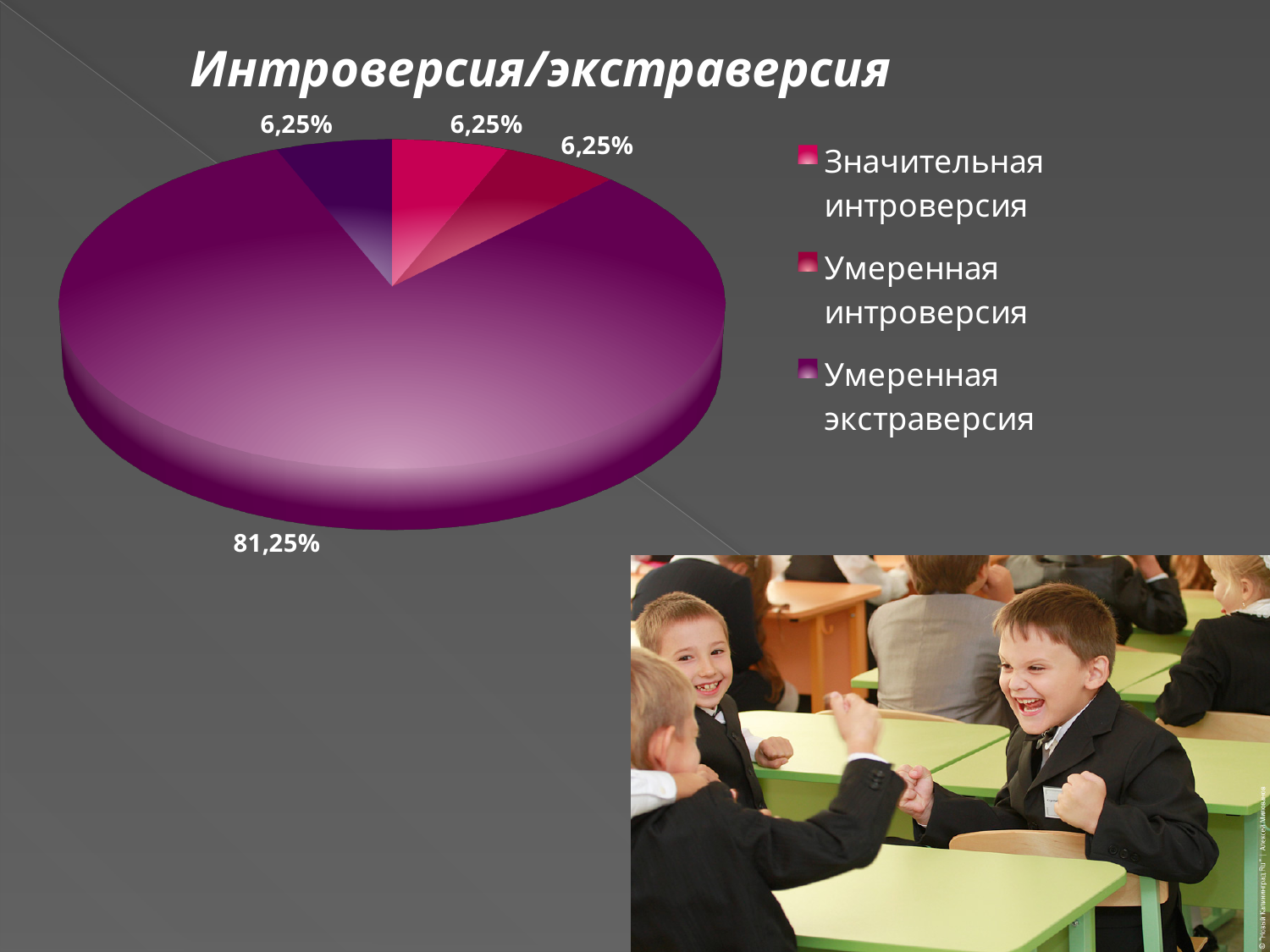
What is the value for Умеренная интроверсия? 6,25% What is the difference between the value for Умеренная экстраверсия and the value for Значительная интроверсия? 75% What is the largest value shown on the pie chart? 81,25% What is the value for Значительная интроверсия? 6,25% How many slices does the pie chart have? 4 How many entries does the legend list? 3 What is the total of all the percentage labels shown on the pie chart? 100% Which is larger, the value for Умеренная экстраверсия or the value for Умеренная интроверсия? Умеренная экстраверсия What is the title of the chart? Интроверсия/экстраверсия Which slice is the largest in the pie chart? Умеренная экстраверсия What share of the pie does Умеренная экстраверсия have? 81,25% What kind of chart is shown on the slide? pie chart